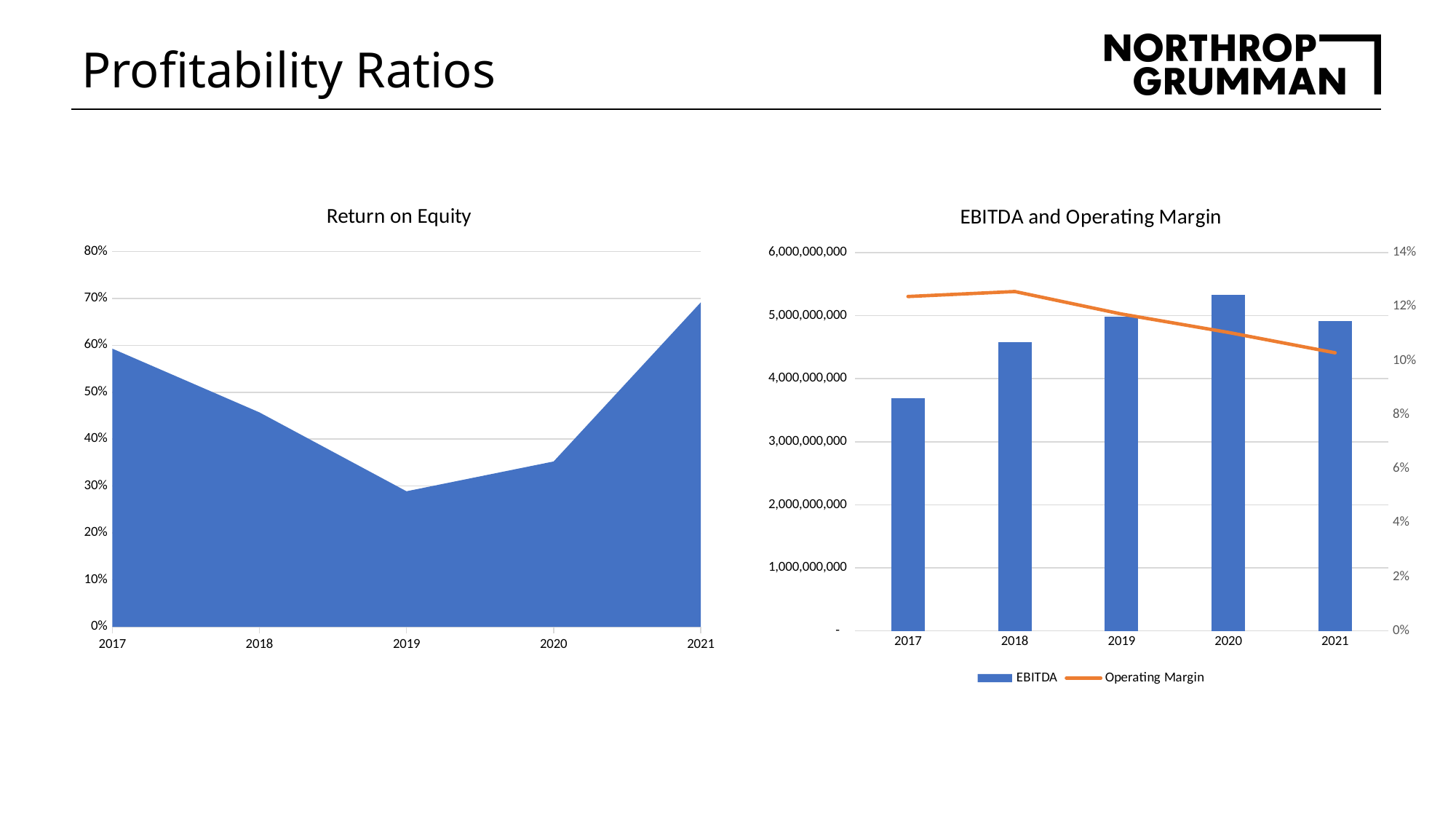
In the Return on Equity chart, which year has the highest return on equity? 2021 In the EBITDA and Operating Margin chart, is the EBITDA for 2017 greater or less than 4,000,000,000? less In the EBITDA and Operating Margin chart, does the Operating Margin rise or fall from 2018 to 2021? fall In the Return on Equity chart, which year has the lowest return on equity? 2019 In the EBITDA and Operating Margin chart, which year has the lowest EBITDA? 2017 How many series does the legend of the EBITDA and Operating Margin chart list? 2 In the Return on Equity chart, which is larger, the value for 2017 or the value for 2018? 2017 What kind of chart is the Return on Equity chart? Area chart In the Return on Equity chart, is the value for 2020 greater or less than 40%? less In the Return on Equity chart, how many years are plotted? 5 In the Return on Equity chart, is the value for 2017 greater or less than 50%? greater In the EBITDA and Operating Margin chart, which year has the highest EBITDA? 2020